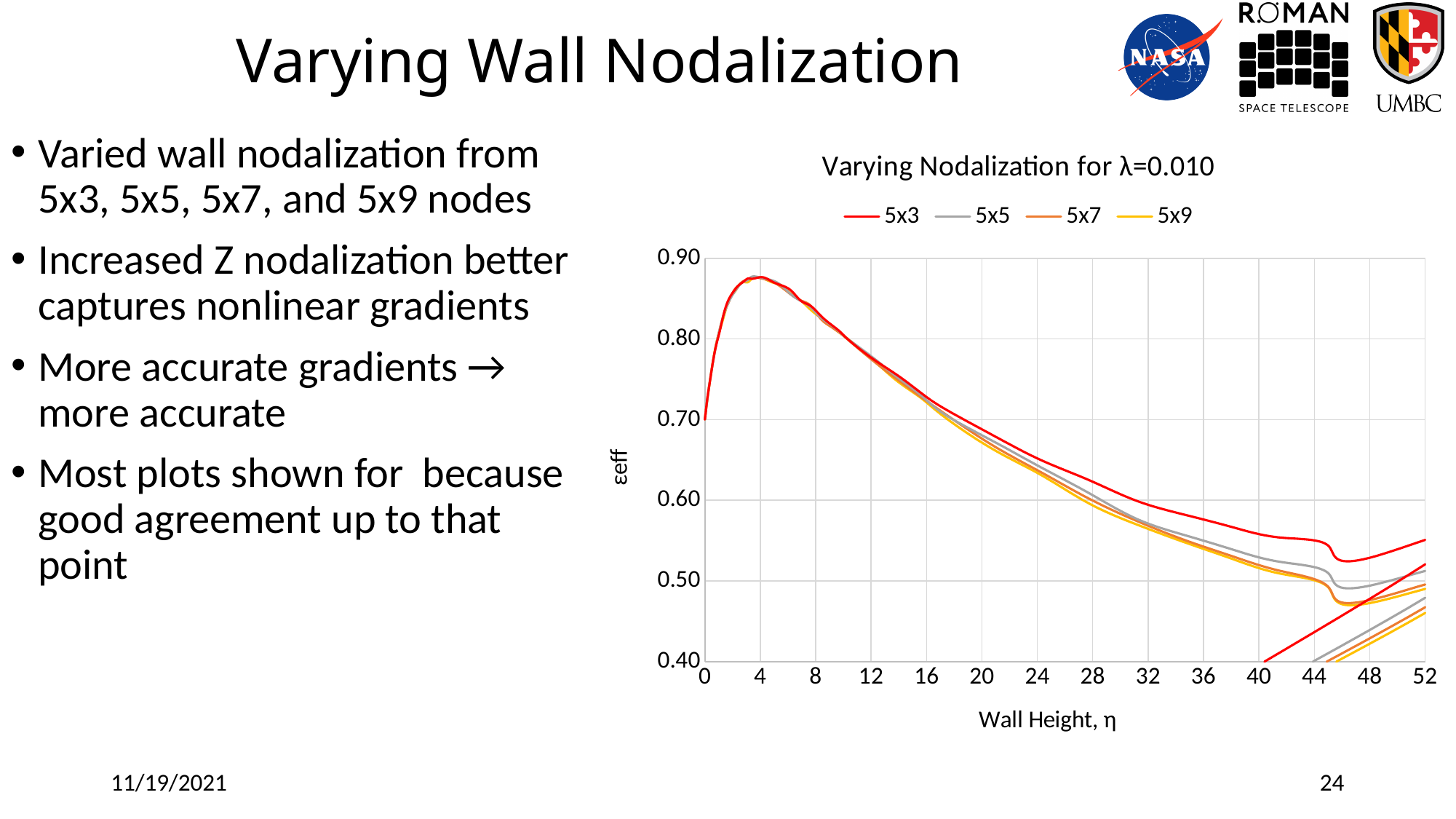
What is the title of the chart? Varying Nodalization for λ=0.010 At a wall height of 44, is the value of the 5x9 series greater or less than 0.60? less At a wall height of 4, is the value of the 5x5 series greater or less than 0.80? greater At a wall height of 32, which series has the higher value, 5x3 or 5x9? 5x3 What kind of chart is shown on the slide? line chart Which colour is used for the 5x3 series in the chart? red At a wall height of 44, which series has the higher value, 5x3 or 5x5? 5x3 At a wall height of 48, is the value of the 5x3 series greater or less than 0.60? less Between wall heights of 4 and 40, do the values of the 5x3 series rise or fall? fall How many series does the legend of the chart list? 4 Between wall heights of 0 and 4, do the values of the 5x3 series rise or fall? rise